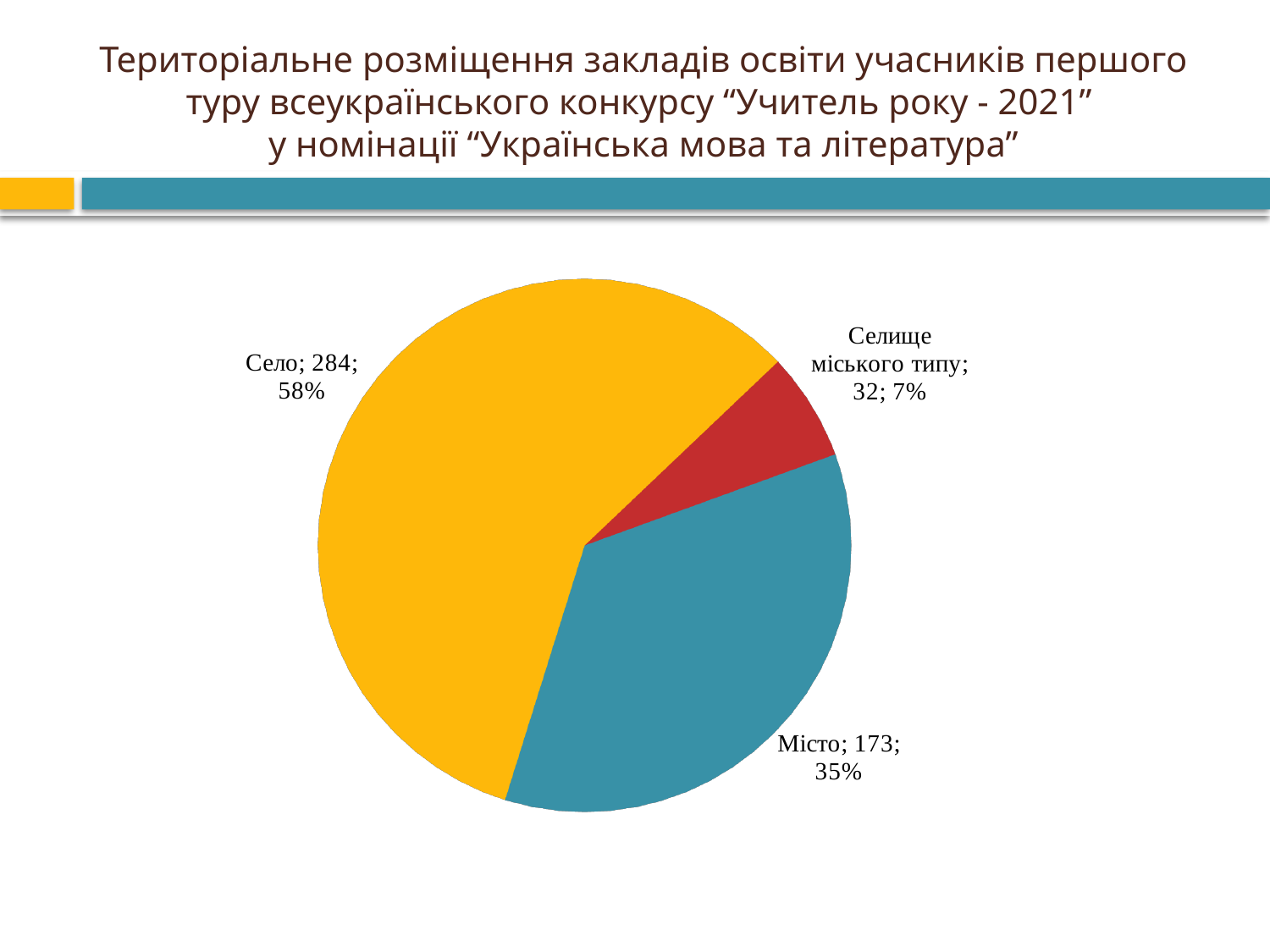
How many slices does the pie chart have? 3 Which category has the largest slice? Село What kind of chart is shown on the slide? pie chart What share of the pie does Селище міського типу represent? 7% What is the value for Місто? 173 What is the difference between the values for Село and Місто? 111 What share of the pie does Місто represent? 35% What share of the pie does Село represent? 58% What is the value for Селище міського типу? 32 What is the value for Село? 284 Which category has the smallest slice? Селище міського типу Which is larger, the value for Місто or the value for Селище міського типу? Місто